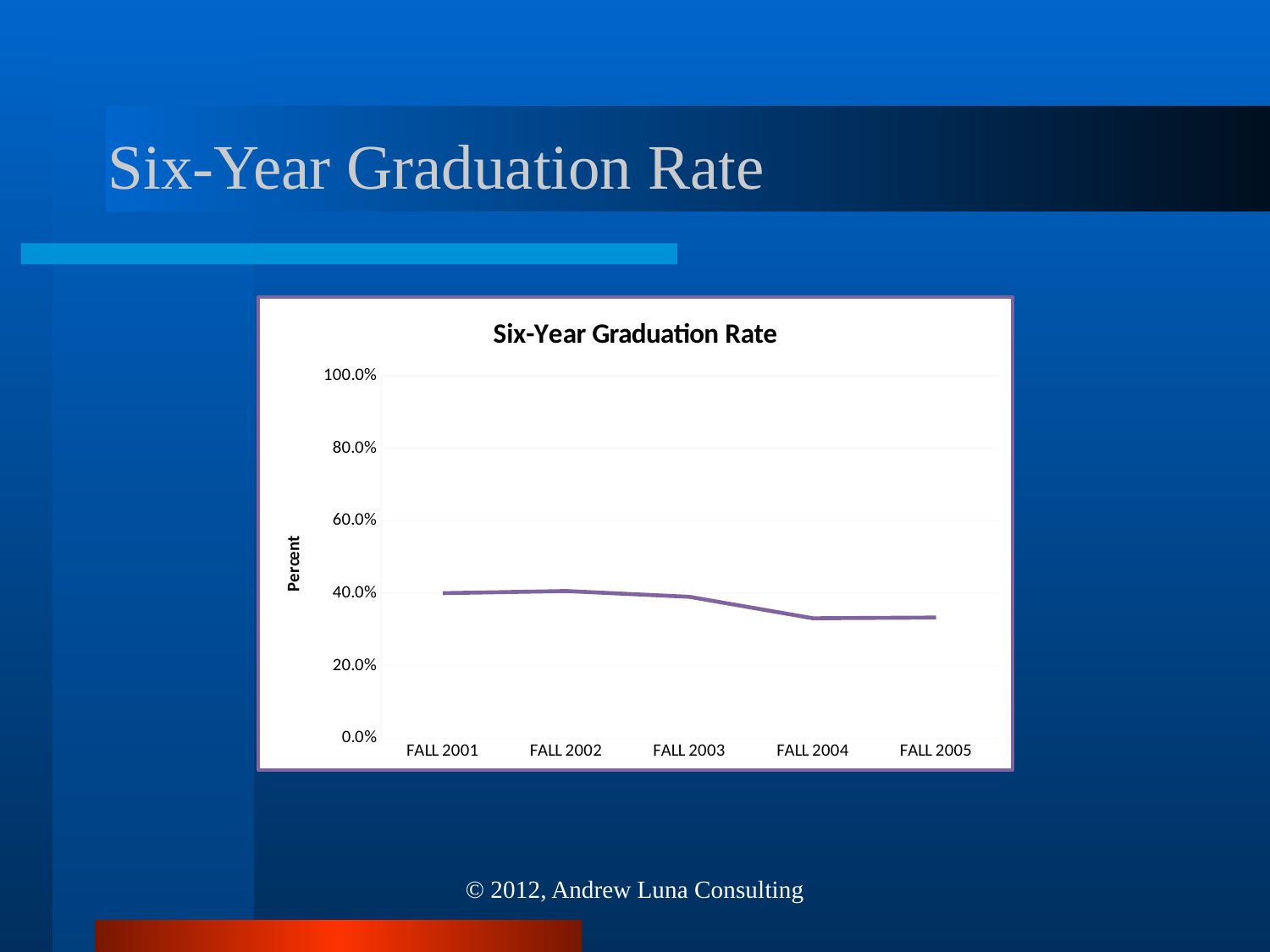
What is the label on the vertical axis of the chart? Percent What kind of chart is shown on the slide? line chart Is the value for FALL 2001 greater or less than 20.0%? greater Which is larger, the value for FALL 2001 or the value for FALL 2004? FALL 2001 What is the first category shown on the x axis? FALL 2001 Is the value for FALL 2004 greater or less than 40.0%? less Overall, do the values rise or fall from FALL 2001 to FALL 2005? fall Which is larger, the value for FALL 2002 or the value for FALL 2005? FALL 2002 Is the value for FALL 2005 greater or less than 20.0%? greater What is the title of the chart? Six-Year Graduation Rate How many data points are plotted on the line? 5